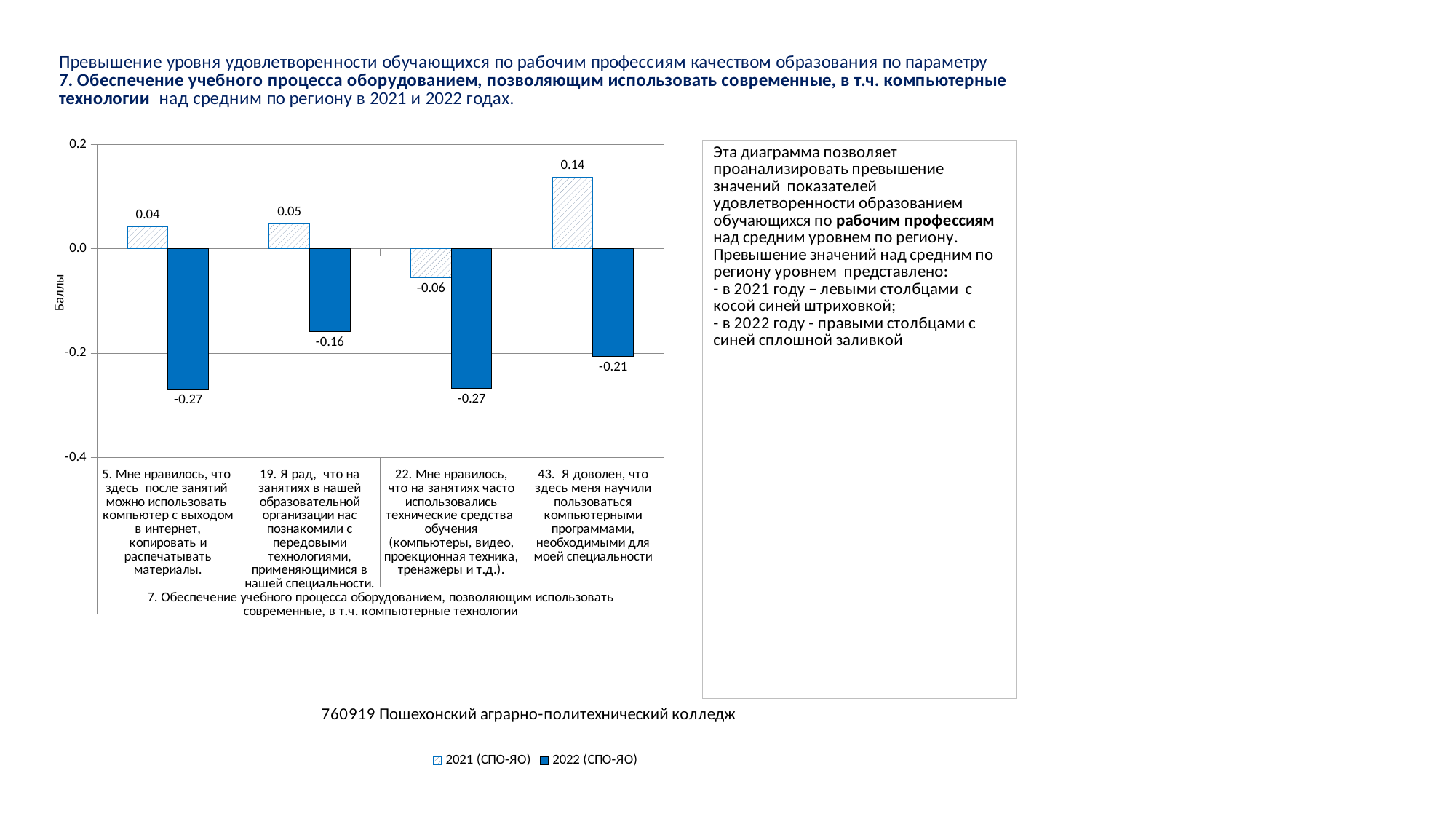
How many series does the legend list? 2 Which category has the highest value for the 2021 (СПО-ЯО) series? 43. Я доволен, что здесь меня научили пользоваться компьютерными программами, необходимыми для моей специальности How many categories are shown on the x axis of the chart? 4 What is the label of the y axis of the chart? Баллы What is the value for 2022 (СПО-ЯО) for category 19 (Я рад, что на занятиях в нашей образовательной организации нас познакомили с передовыми технологиями)? -0.16 What is the difference between the 2021 and 2022 values for category 43? 0.35 What is the value for 2021 (СПО-ЯО) for category 43 (Я доволен, что здесь меня научили пользоваться компьютерными программами)? 0.14 What is the value for 2021 (СПО-ЯО) for category 22 (Мне нравилось, что на занятиях часто использовались технические средства обучения)? -0.06 What is the difference between the 2021 and 2022 values for category 5? 0.31 Which category has the highest (least negative) value for the 2022 (СПО-ЯО) series? 19. Я рад, что на занятиях в нашей образовательной организации нас познакомили с передовыми технологиями, применяющимися в нашей специальности. Which is larger: the 2022 value for category 19 or the 2022 value for category 43? Category 19 (-0.16) What kind of chart is shown on the slide? Bar chart